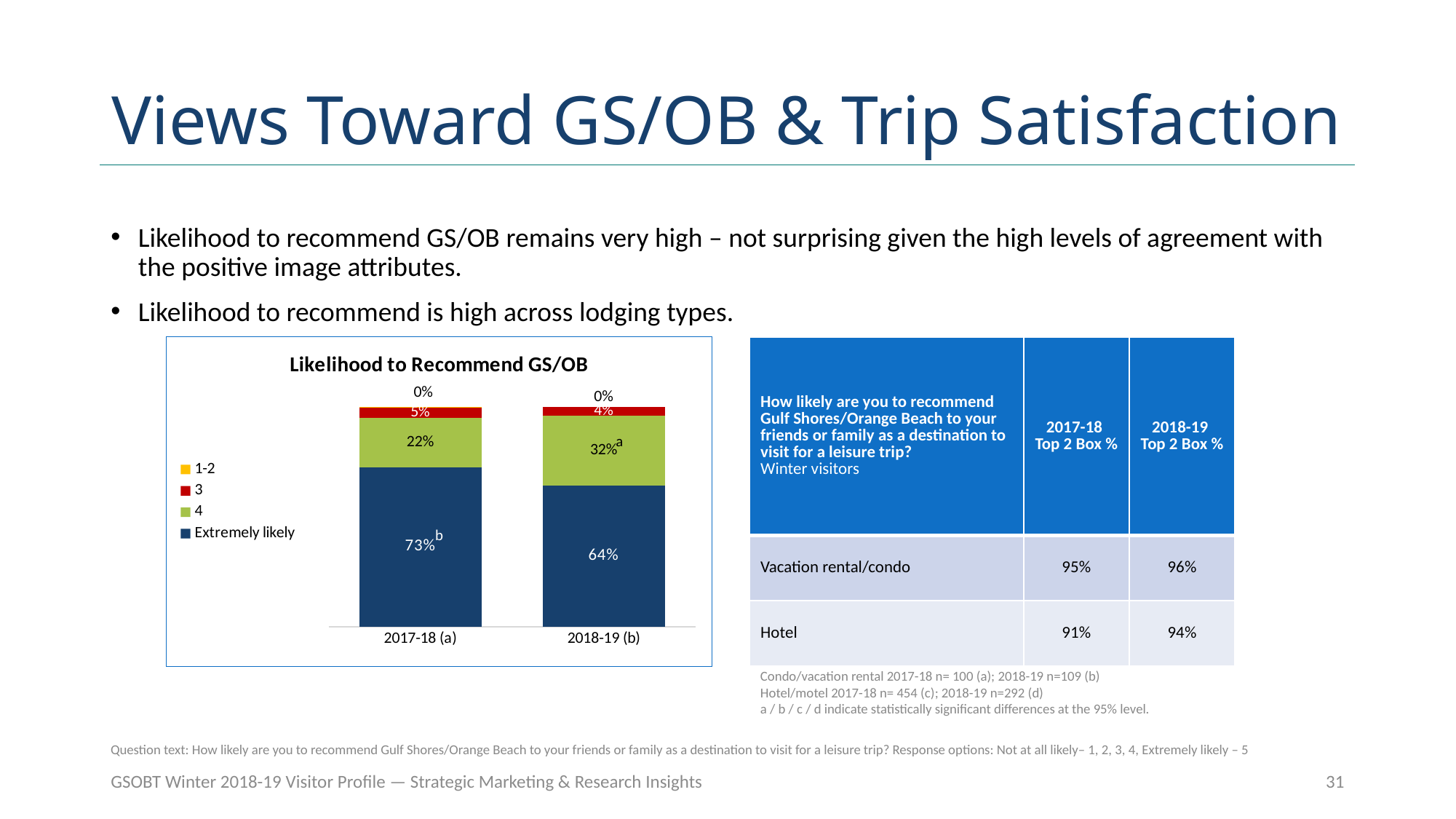
In the Likelihood to Recommend GS/OB chart, what is the value for the 4 rating in 2018-19 (b)? 32% In the Likelihood to Recommend GS/OB chart, what is the value for the 1-2 rating in 2018-19 (b)? 0% How many series does the legend of the Likelihood to Recommend GS/OB chart list? 4 What kind of chart is the Likelihood to Recommend GS/OB chart? Stacked bar chart In the Likelihood to Recommend GS/OB chart, what is the value for the 3 rating in 2017-18 (a)? 5% In the Likelihood to Recommend GS/OB chart, which year has the higher Extremely likely share, 2017-18 (a) or 2018-19 (b)? 2017-18 (a) In the Likelihood to Recommend GS/OB chart, what is the value for Extremely likely in 2017-18 (a)? 73% In the Likelihood to Recommend GS/OB chart, what is the total of the stacked bar for 2017-18 (a)? 100% How many categories are shown on the x axis of the Likelihood to Recommend GS/OB chart? 2 In the Likelihood to Recommend GS/OB chart, what is the difference between the 4 rating values for 2018-19 (b) and 2017-18 (a)? 10% In the Likelihood to Recommend GS/OB chart, what is the difference between the Extremely likely values for 2017-18 (a) and 2018-19 (b)? 9% In the Likelihood to Recommend GS/OB chart, what is the value for Extremely likely in 2018-19 (b)? 64%